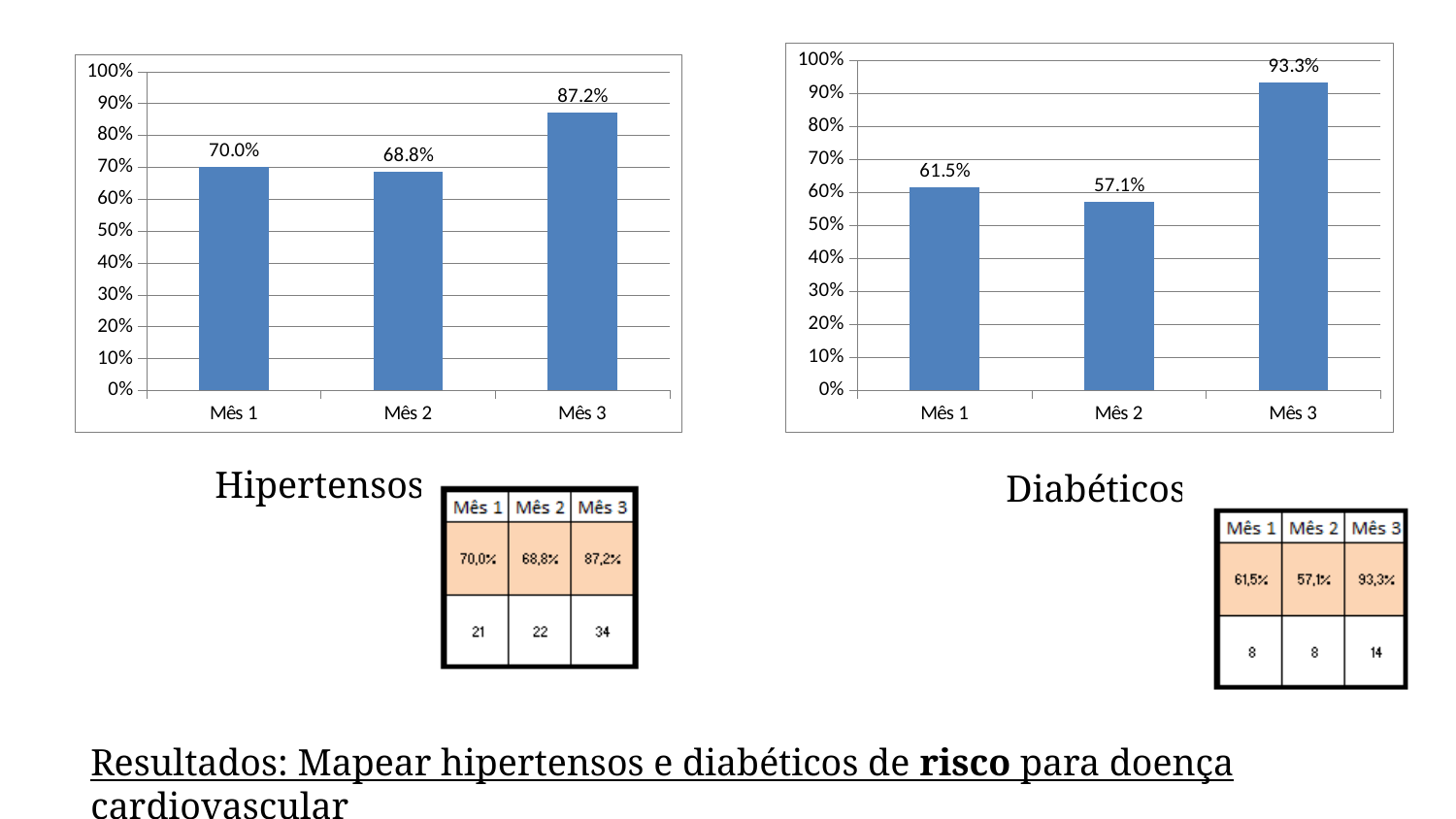
How many categories are shown on the x axis of the Hipertensos chart (left)? 3 In the Hipertensos chart (left), what is the value for Mês 1? 70.0% In the Diabéticos chart (right), what is the difference between the values for Mês 3 and Mês 2? 36.2% In the Hipertensos chart (left), is the value for Mês 3 greater or less than 80%? greater In the Diabéticos chart (right), which month has the highest value? Mês 3 In the Hipertensos chart (left), which month has the lowest value? Mês 2 In the Diabéticos chart (right), is the value for Mês 2 greater or less than 60%? less In the Diabéticos chart (right), which is larger, the value for Mês 1 or Mês 2? Mês 1 In the Hipertensos chart (left), what is the value for Mês 3? 87.2% In the Diabéticos chart (right), what is the value for Mês 2? 57.1% In the Hipertensos chart (left), what is the difference between the values for Mês 3 and Mês 1? 17.2% What kind of chart is the Diabéticos chart (right)? bar chart